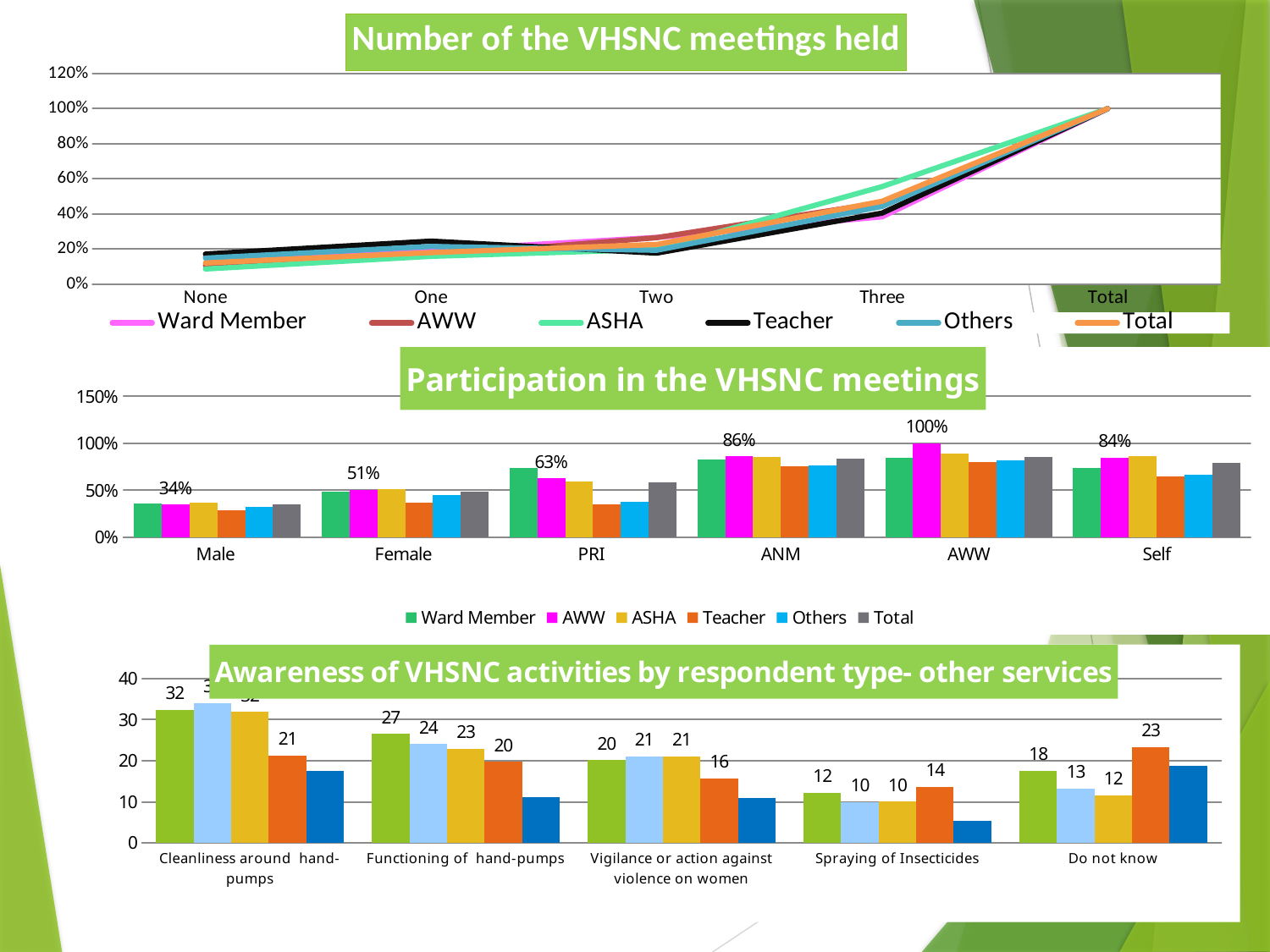
In the 'Participation in the VHSNC meetings' chart, what is the data label shown for the AWW category? 100% What kind of chart is the top chart, 'Number of the VHSNC meetings held'? line chart In the 'Awareness of VHSNC activities by respondent type- other services' chart, what is the value of the orange bar for Do not know? 23 In the 'Number of the VHSNC meetings held' chart, is the Teacher value at None greater or less than 40%? less In the 'Number of the VHSNC meetings held' chart, do the lines generally rise or fall from None to Total? rise In the 'Awareness of VHSNC activities by respondent type- other services' chart, what is the value of the first (green) bar for Functioning of hand-pumps? 27 What kind of chart is 'Participation in the VHSNC meetings'? bar chart In the 'Awareness of VHSNC activities by respondent type- other services' chart, how many categories are shown on the x axis? 5 How many series does the legend of the 'Number of the VHSNC meetings held' chart list? 6 In the 'Participation in the VHSNC meetings' chart, which category has the lowest labelled value? Male How many categories are shown on the x axis of the 'Participation in the VHSNC meetings' chart? 6 In the 'Number of the VHSNC meetings held' chart, what value do all the lines reach at Total? 100%